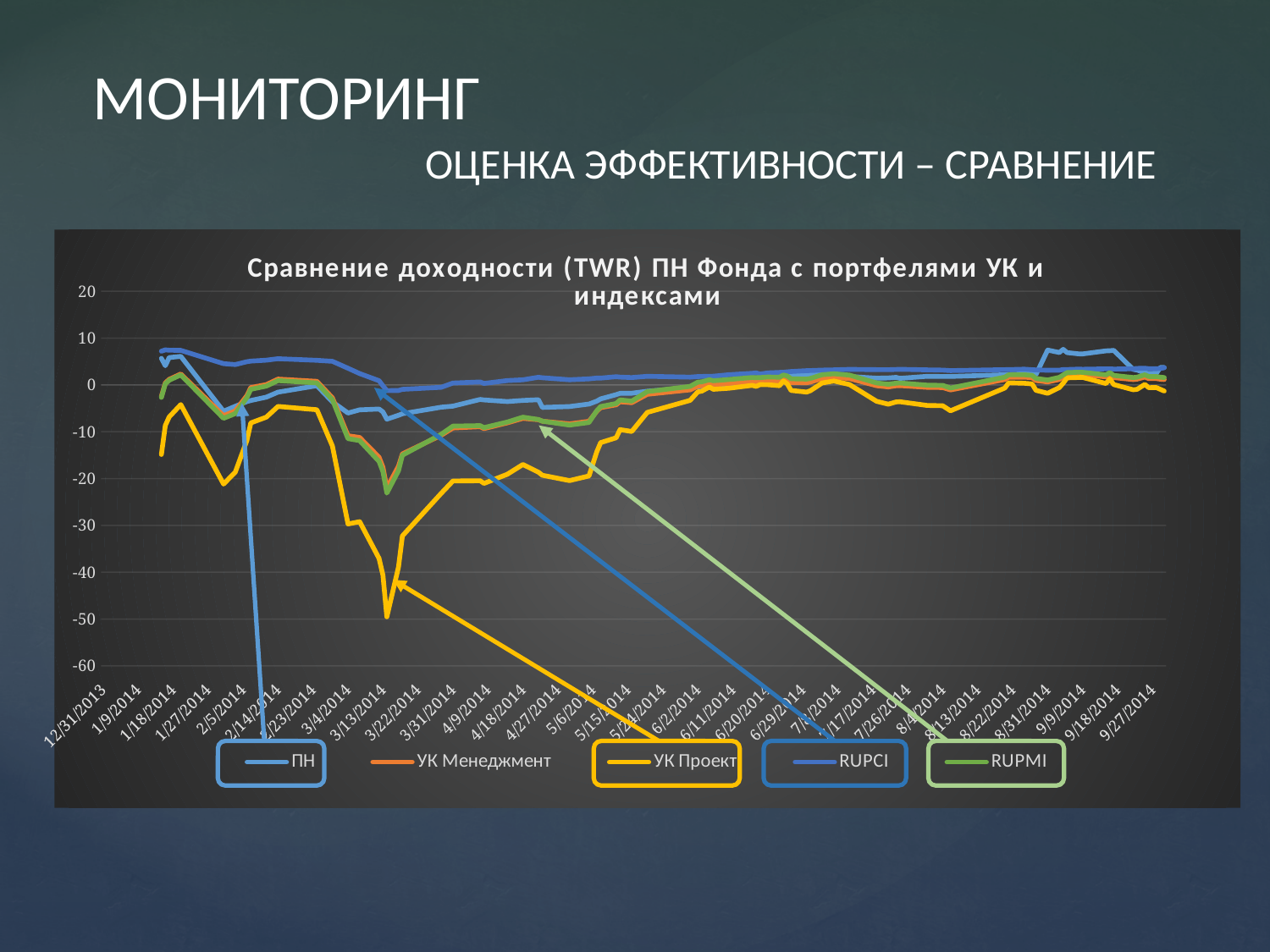
Which series reaches the lowest value on the chart? УК Проект Is the value of the RUPCI series at 1/18/2014 greater or less than 0? greater What is the title of the chart? Сравнение доходности (TWR) ПН Фонда с портфелями УК и индексами How many series does the legend of the chart list? 5 Does the УК Проект series rise or fall between 3/22/2014 and 9/27/2014? rise Does the УК Проект series rise or fall between 2/23/2014 and 3/22/2014? fall Which series in the legend is drawn in orange? УК Менеджмент Around 3/22/2014, which series has the larger value, RUPCI or УК Проект? RUPCI Is the lowest value of the УК Проект series greater or less than -40? less What is the lowest value shown on the vertical axis of the chart? -60 What kind of chart is shown on the slide? line chart